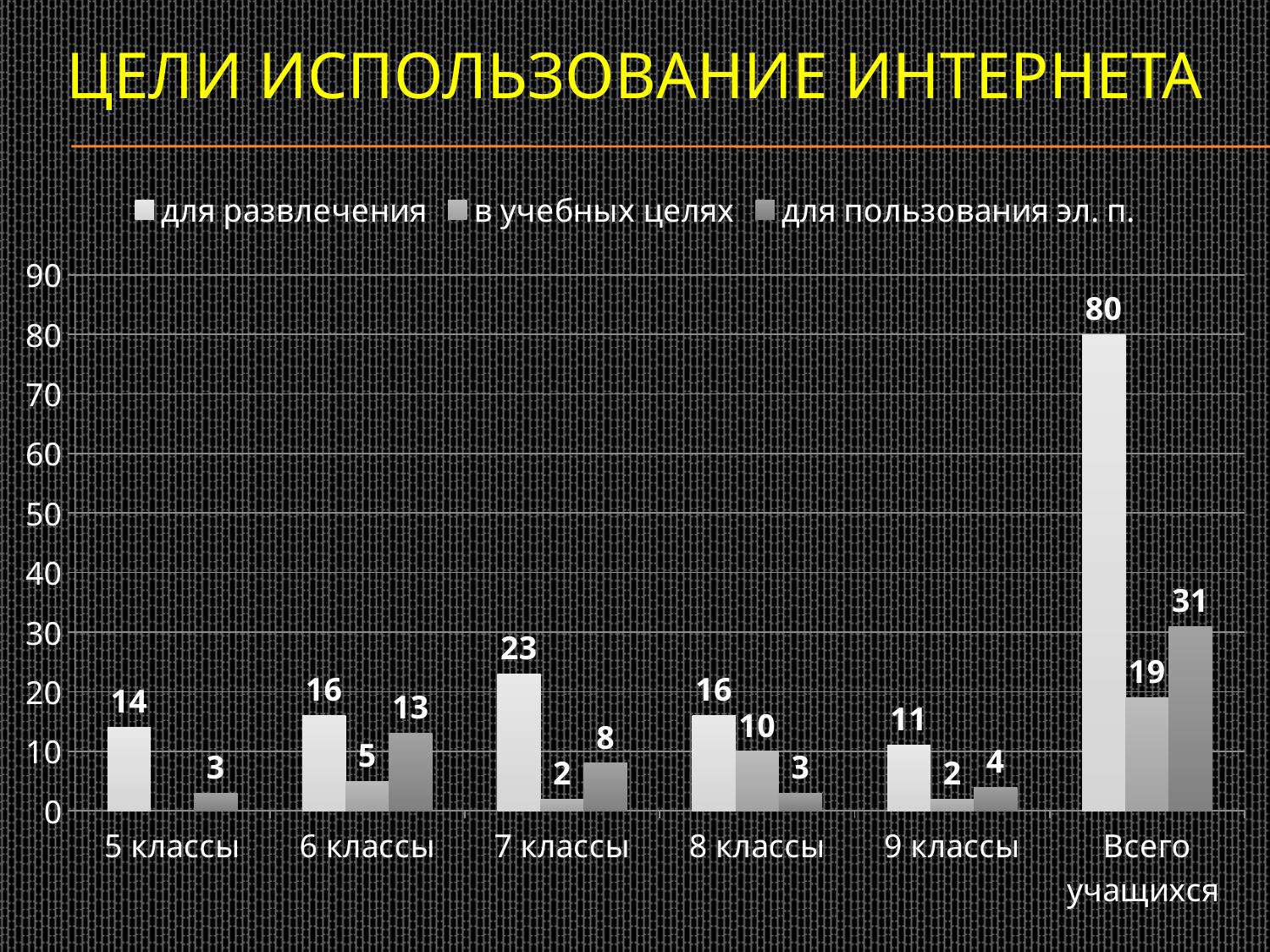
How many categories are shown on the x axis? 6 What is the value for 'для пользования эл. п.' in the '6 классы' category? 13 How many series does the legend list? 3 Among the class categories (5 to 9 классы), which has the highest value for 'для развлечения'? 7 классы What type of chart is shown on the slide? bar chart What is the difference between 'для развлечения' and 'в учебных целях' in the 'Всего учащихся' category? 61 What is the value for 'в учебных целях' in the '8 классы' category? 10 What is the title of the slide? ЦЕЛИ ИСПОЛЬЗОВАНИЕ ИНТЕРНЕТА What is the value for 'для развлечения' in the '7 классы' category? 23 What is the value for 'для развлечения' in the 'Всего учащихся' category? 80 Which is larger in the '9 классы' category: 'в учебных целях' or 'для пользования эл. п.'? для пользования эл. п.